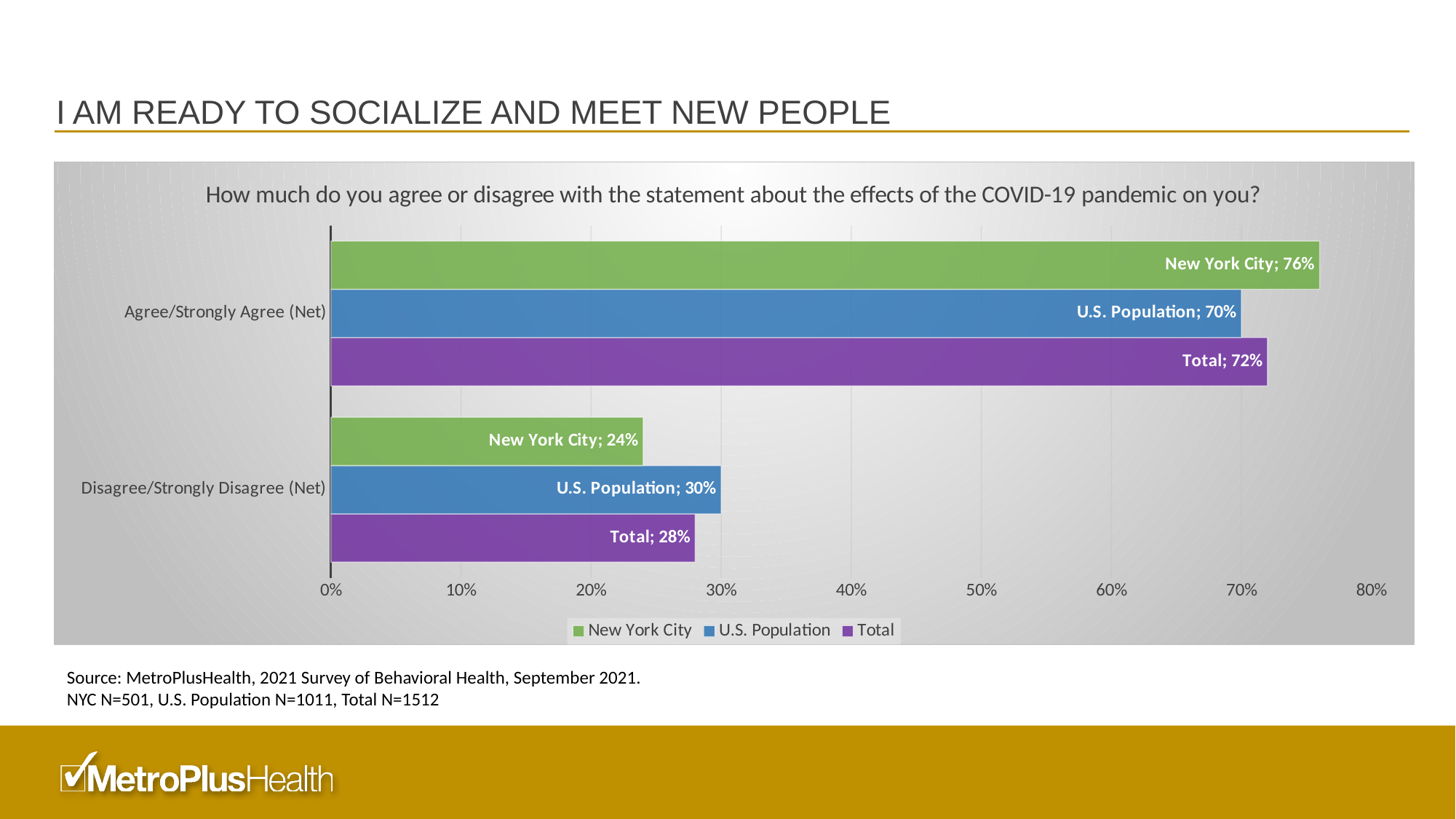
What is the difference between the U.S. Population and Total values for Disagree/Strongly Disagree (Net)? 2% What is the Total value for Agree/Strongly Agree (Net)? 72% Which is larger for Disagree/Strongly Disagree (Net): New York City or U.S. Population? U.S. Population What is the difference between the New York City and U.S. Population values for Agree/Strongly Agree (Net)? 6% What colour are the Total bars in the chart? Purple How many series does the legend list? 3 What is the U.S. Population value for Disagree/Strongly Disagree (Net)? 30% What kind of chart is shown on the slide? Bar chart Which series has the lowest value for Disagree/Strongly Disagree (Net)? New York City What percentage of New York City respondents agree or strongly agree (net) with the statement? 76% Which series has the highest value for Agree/Strongly Agree (Net)? New York City Is the Total value for Agree/Strongly Agree (Net) greater or less than 70%? greater